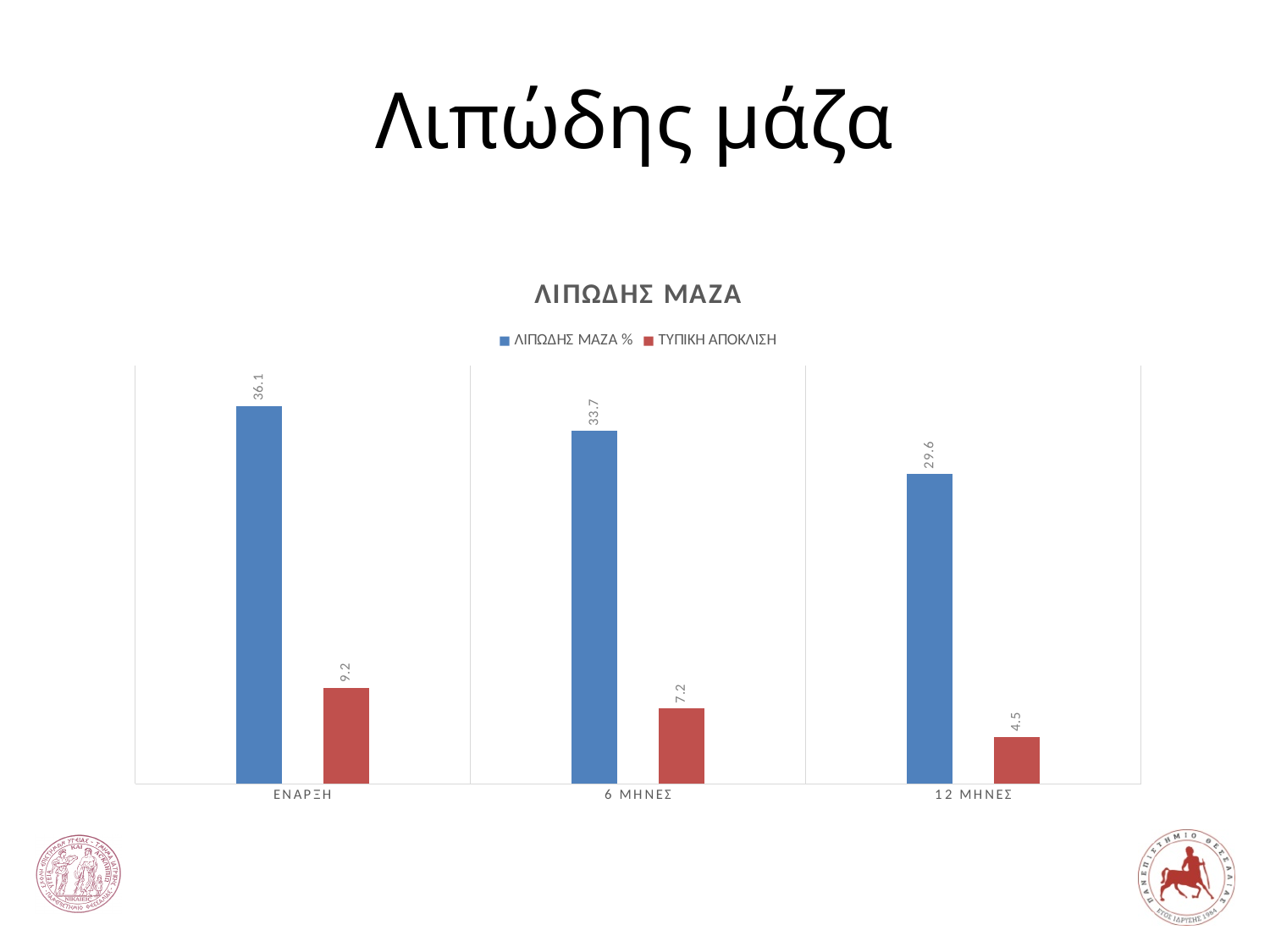
What is the value of ΛΙΠΩΔΗΣ ΜΑΖΑ % at 12 ΜΗΝΕΣ? 29.6 What is the value of ΛΙΠΩΔΗΣ ΜΑΖΑ % at ΕΝΑΡΞΗ? 36.1 At which time point is ΛΙΠΩΔΗΣ ΜΑΖΑ % highest? ΕΝΑΡΞΗ What kind of chart is shown? Bar chart What is the value of ΤΥΠΙΚΗ ΑΠΟΚΛΙΣΗ at ΕΝΑΡΞΗ? 9.2 What is the value of ΤΥΠΙΚΗ ΑΠΟΚΛΙΣΗ at 6 ΜΗΝΕΣ? 7.2 How many time points (categories) are shown on the x axis? 3 What is the difference between ΛΙΠΩΔΗΣ ΜΑΖΑ % at ΕΝΑΡΞΗ and at 12 ΜΗΝΕΣ? 6.5 At which time point is ΤΥΠΙΚΗ ΑΠΟΚΛΙΣΗ lowest? 12 ΜΗΝΕΣ Which is larger: ΤΥΠΙΚΗ ΑΠΟΚΛΙΣΗ at ΕΝΑΡΞΗ or at 6 ΜΗΝΕΣ? ΕΝΑΡΞΗ Does ΛΙΠΩΔΗΣ ΜΑΖΑ % rise or fall from ΕΝΑΡΞΗ to 12 ΜΗΝΕΣ? Fall How many series does the legend list? 2